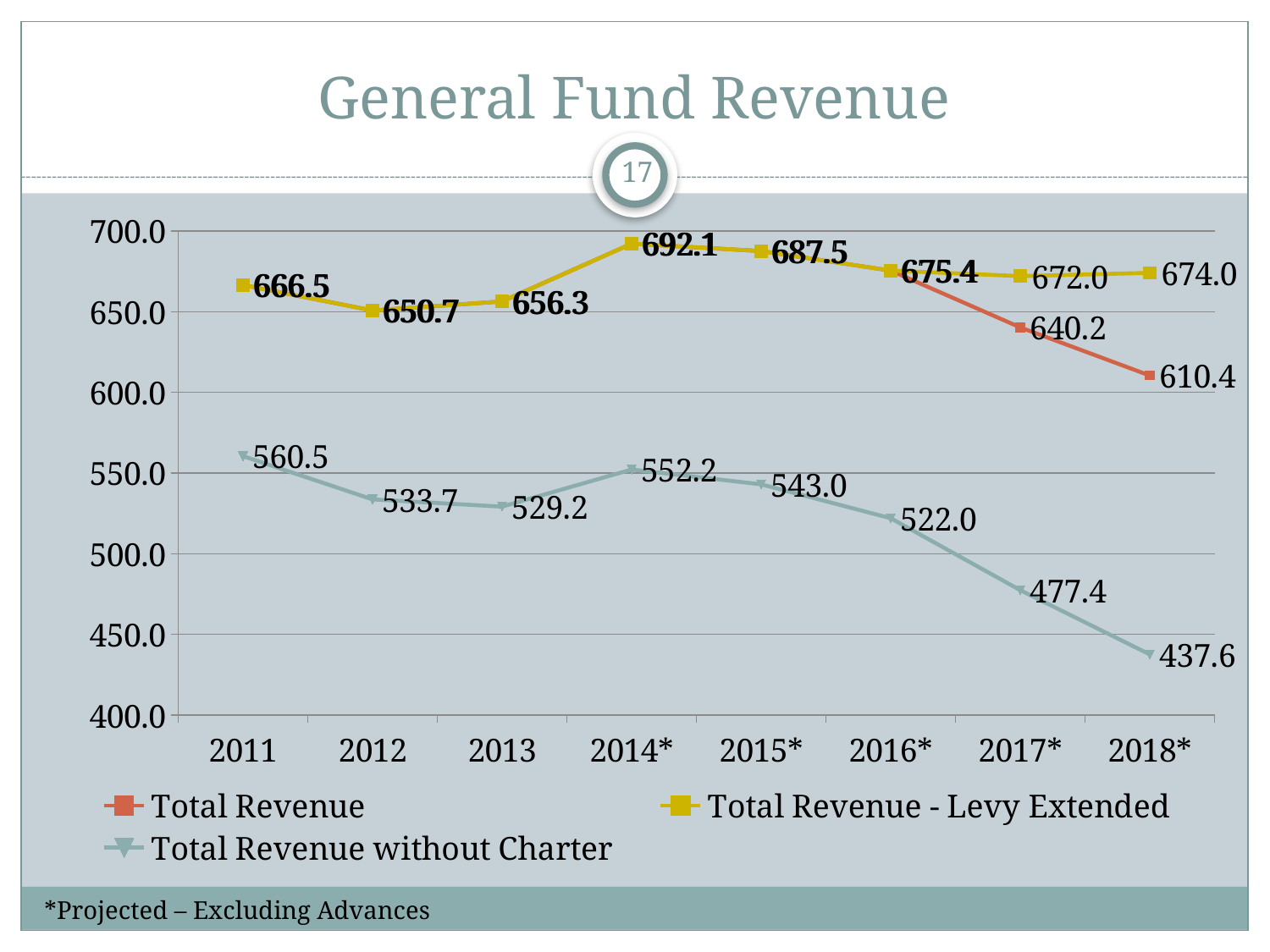
How many series does the legend list? 3 Which is larger in 2017*: Total Revenue or Total Revenue - Levy Extended? Total Revenue - Levy Extended Does Total Revenue without Charter rise or fall from 2015* to 2018*? fall What is the title of the chart? General Fund Revenue In which year is Total Revenue without Charter highest? 2011 How many years are shown on the x axis? 8 What type of chart is shown on the slide? line chart What is the value of Total Revenue without Charter in 2013? 529.2 In which year is Total Revenue without Charter lowest? 2018* What is the value of Total Revenue in 2018*? 610.4 What is the difference between Total Revenue - Levy Extended and Total Revenue in 2018*? 63.6 What is the value of Total Revenue - Levy Extended in 2018*? 674.0